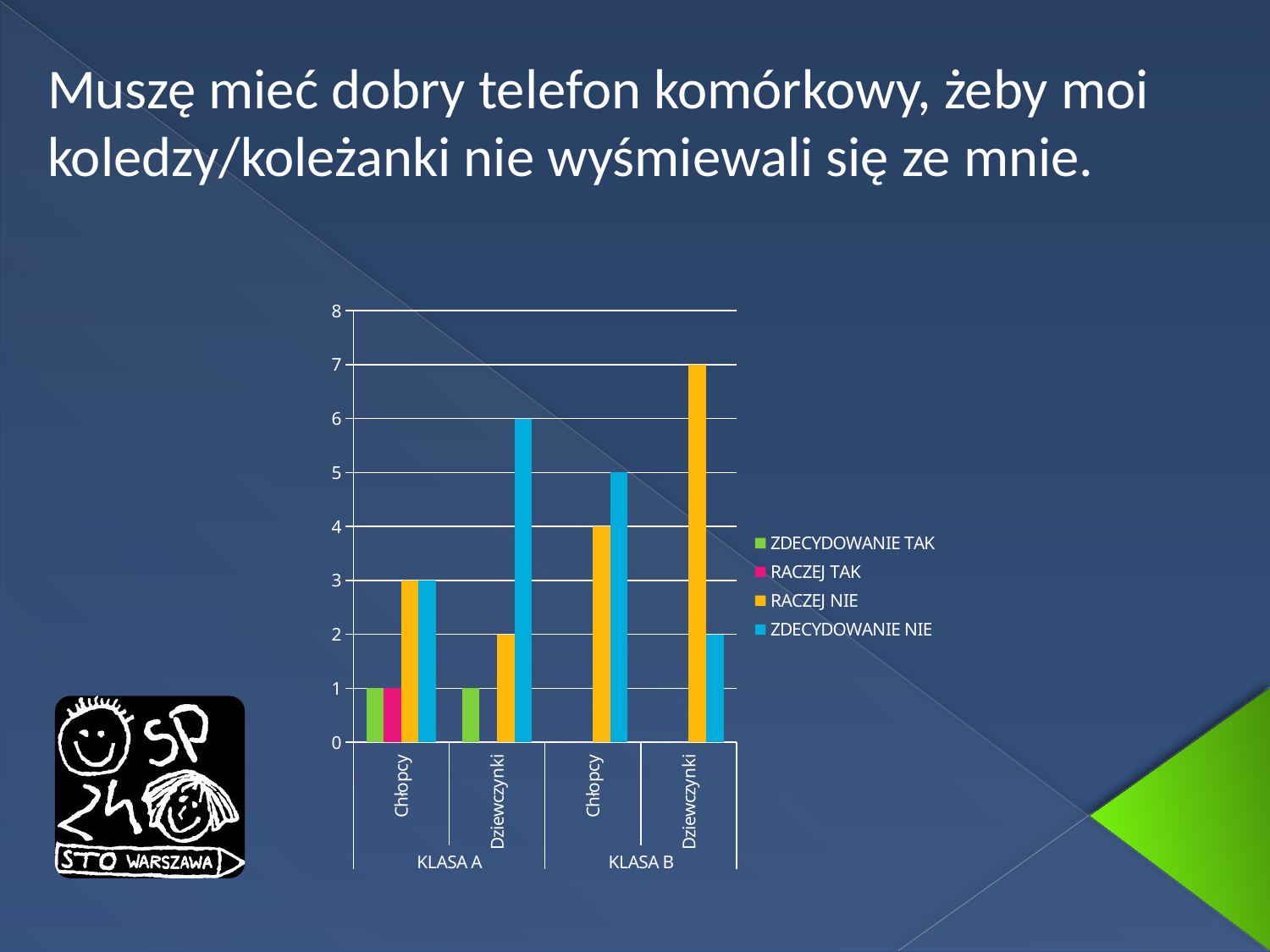
What is the difference between the ZDECYDOWANIE NIE values for Dziewczynki in KLASA A and Dziewczynki in KLASA B? 4 Which group has the lowest ZDECYDOWANIE NIE value? Dziewczynki in KLASA B What is the value of ZDECYDOWANIE NIE for Chłopcy in KLASA B? 5 Which group has the highest RACZEJ NIE value? Dziewczynki in KLASA B How many series does the legend list? 4 Which is larger for Chłopcy in KLASA B: RACZEJ NIE or ZDECYDOWANIE NIE? ZDECYDOWANIE NIE What kind of chart is shown on the slide? bar chart How many groups are shown along the x axis? 4 Which series is shown in orange in the legend? RACZEJ NIE What is the value of ZDECYDOWANIE NIE for Dziewczynki in KLASA A? 6 What is the value of RACZEJ NIE for Chłopcy in KLASA A? 3 What is the value of RACZEJ NIE for Dziewczynki in KLASA B? 7